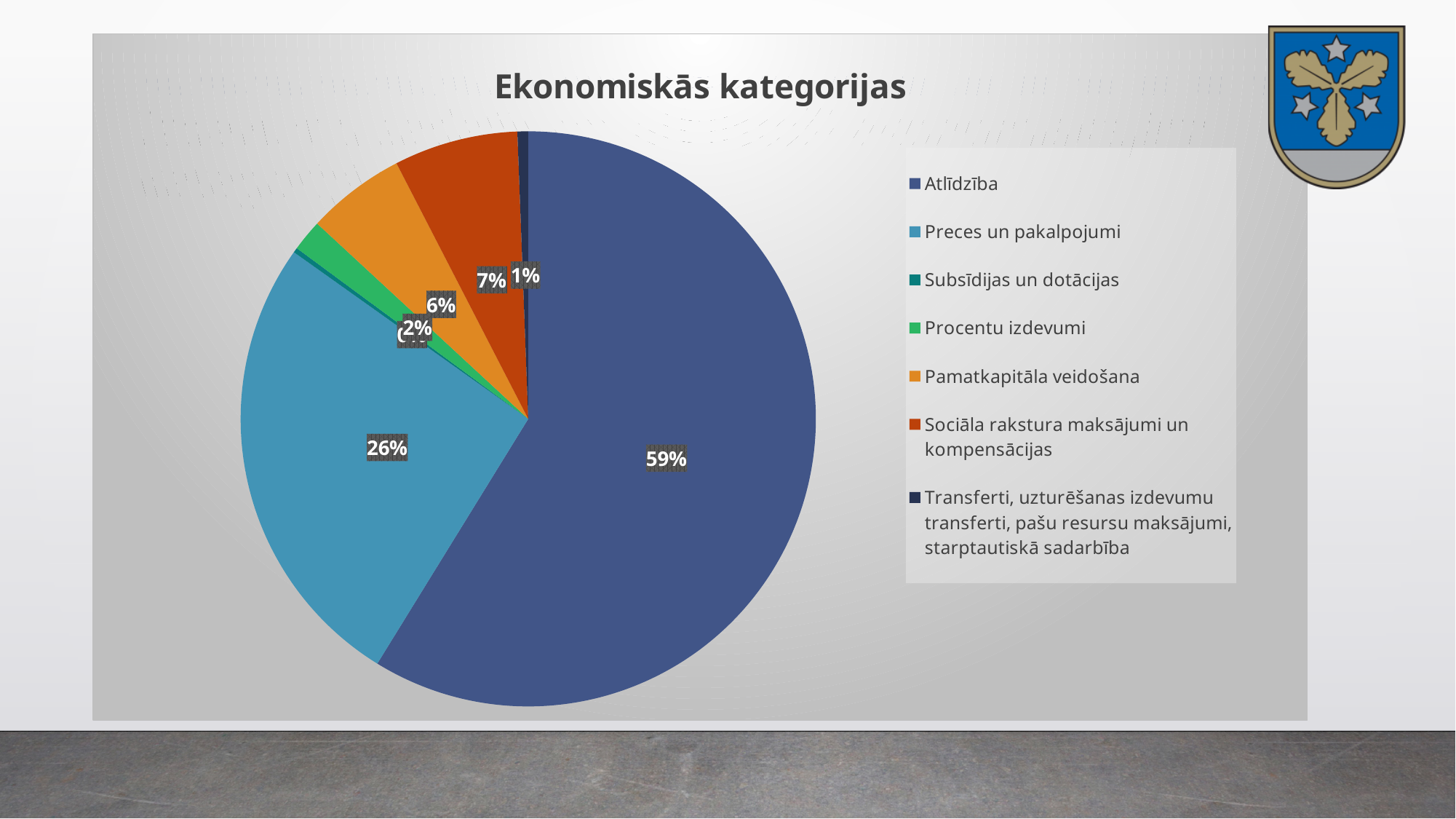
Which is larger: Preces un pakalpojumi or Sociāla rakstura maksājumi un kompensācijas? Preces un pakalpojumi What percentage is shown for Pamatkapitāla veidošana? 6% What percentage is labelled for the Transferti, uzturēšanas izdevumu transferti, pašu resursu maksājumi, starptautiskā sadarbība slice? 1% What share does Sociāla rakstura maksājumi un kompensācijas have in the pie? 7% What is the title of the chart? Ekonomiskās kategorijas Which category has the largest slice of the pie? Atlīdzība What share of the pie does Atlīdzība account for? 59% What colour is the Pamatkapitāla veidošana slice? Orange By how many percentage points does Atlīdzība exceed Preces un pakalpojumi? 33 percentage points How many categories does the legend list? 7 What percentage is shown for Preces un pakalpojumi? 26% What type of chart is shown on the slide? Pie chart